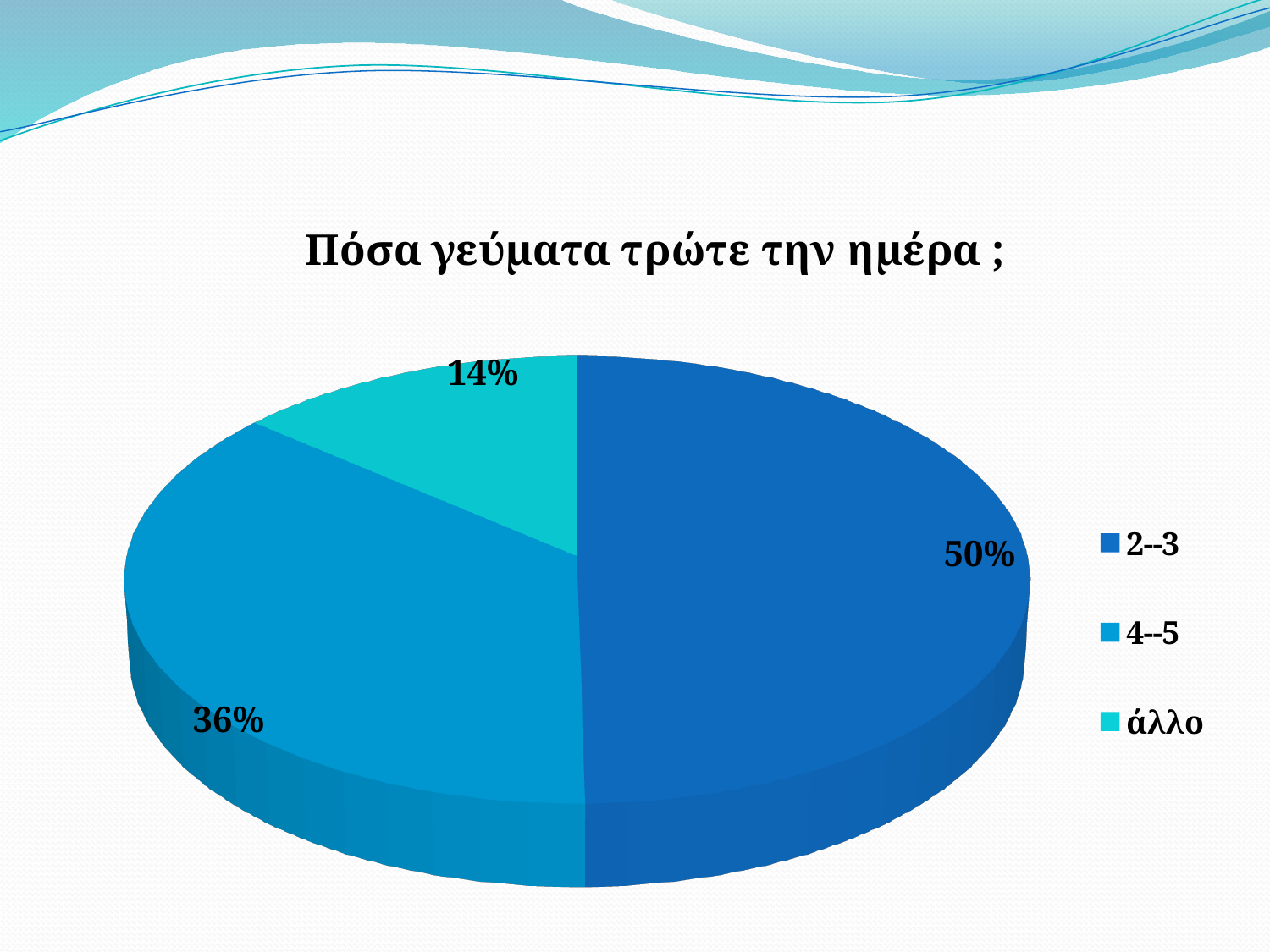
What is the title of the chart? Πόσα γεύματα τρώτε την ημέρα ; Which category has the largest slice of the pie? 2--3 What share of the pie does the "2--3" slice represent? 50% What is the difference in percentage points between the "2--3" slice and the "4--5" slice? 14 What is the difference in percentage points between the "4--5" slice and the "άλλο" slice? 22 What share of the pie does the "4--5" slice represent? 36% What share of the pie does the "άλλο" slice represent? 14% How many entries does the legend list? 3 How many slices does the pie chart have? 3 Which category has the smallest slice of the pie? άλλο What kind of chart is shown on the slide? Pie chart Which slice is larger, "4--5" or "άλλο"? 4--5